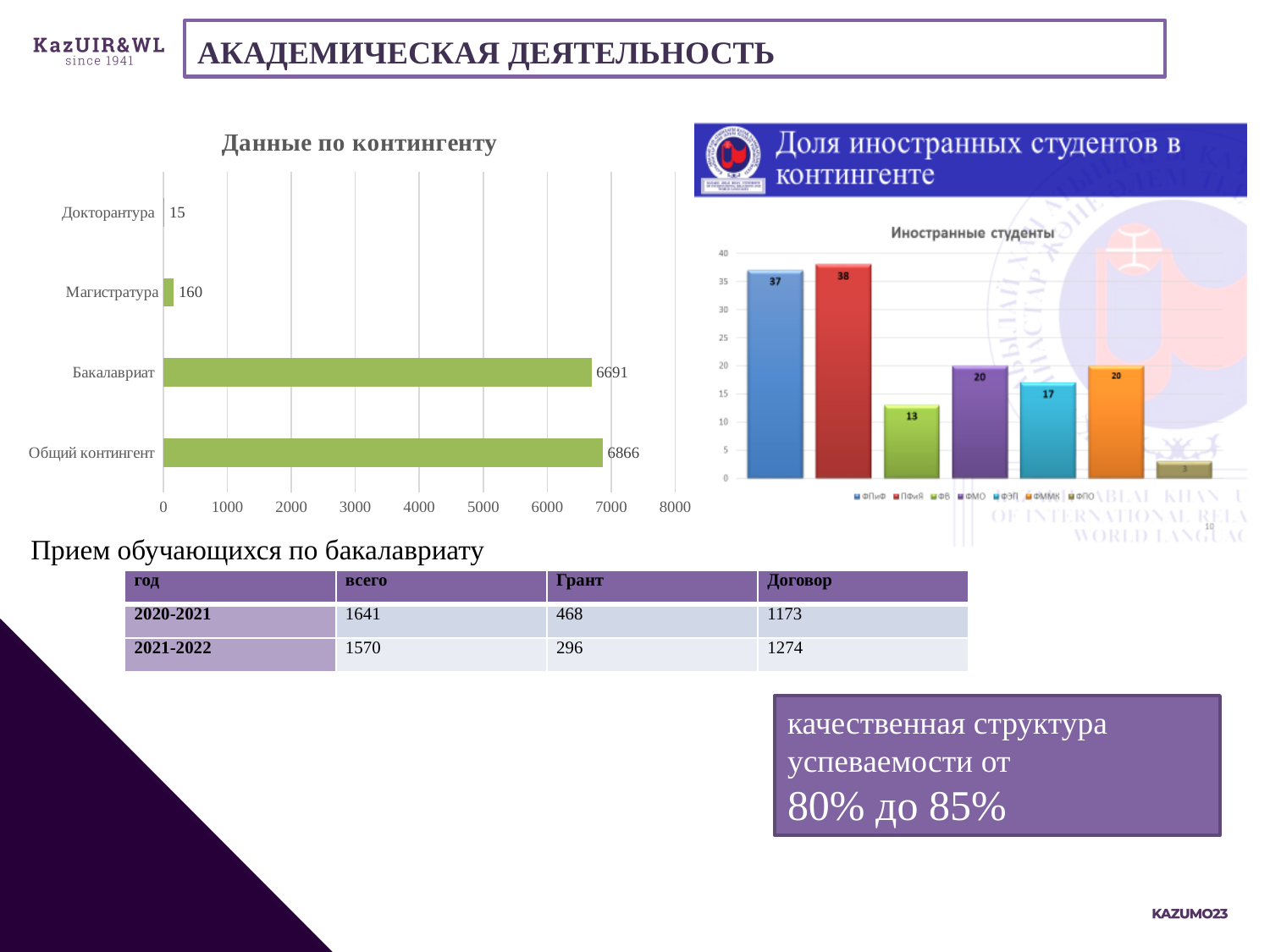
In the chart titled "Данные по контингенту", what is the value for Бакалавриат? 6691 In the chart titled "Данные по контингенту", which category has the highest value? Общий контингент In the chart titled "Данные по контингенту", what is the value for Общий контингент? 6866 In the chart titled "Данные по контингенту", what is the value for Магистратура? 160 In the chart titled "Иностранные студенты" on the right, what is the lowest value shown on a bar? 3 How many bars are shown in the chart titled "Иностранные студенты" on the right? 7 How many categories are shown in the chart titled "Данные по контингенту"? 4 What kind of chart is "Данные по контингенту"? Bar chart In the chart titled "Данные по контингенту", what is the difference between Общий контингент and Бакалавриат? 175 In the chart titled "Иностранные студенты" on the right, what is the highest value shown on a bar? 38 In the chart titled "Данные по контингенту", which category has the lowest value? Докторантура In the chart titled "Данные по контингенту", which is larger: Магистратура or Докторантура? Магистратура